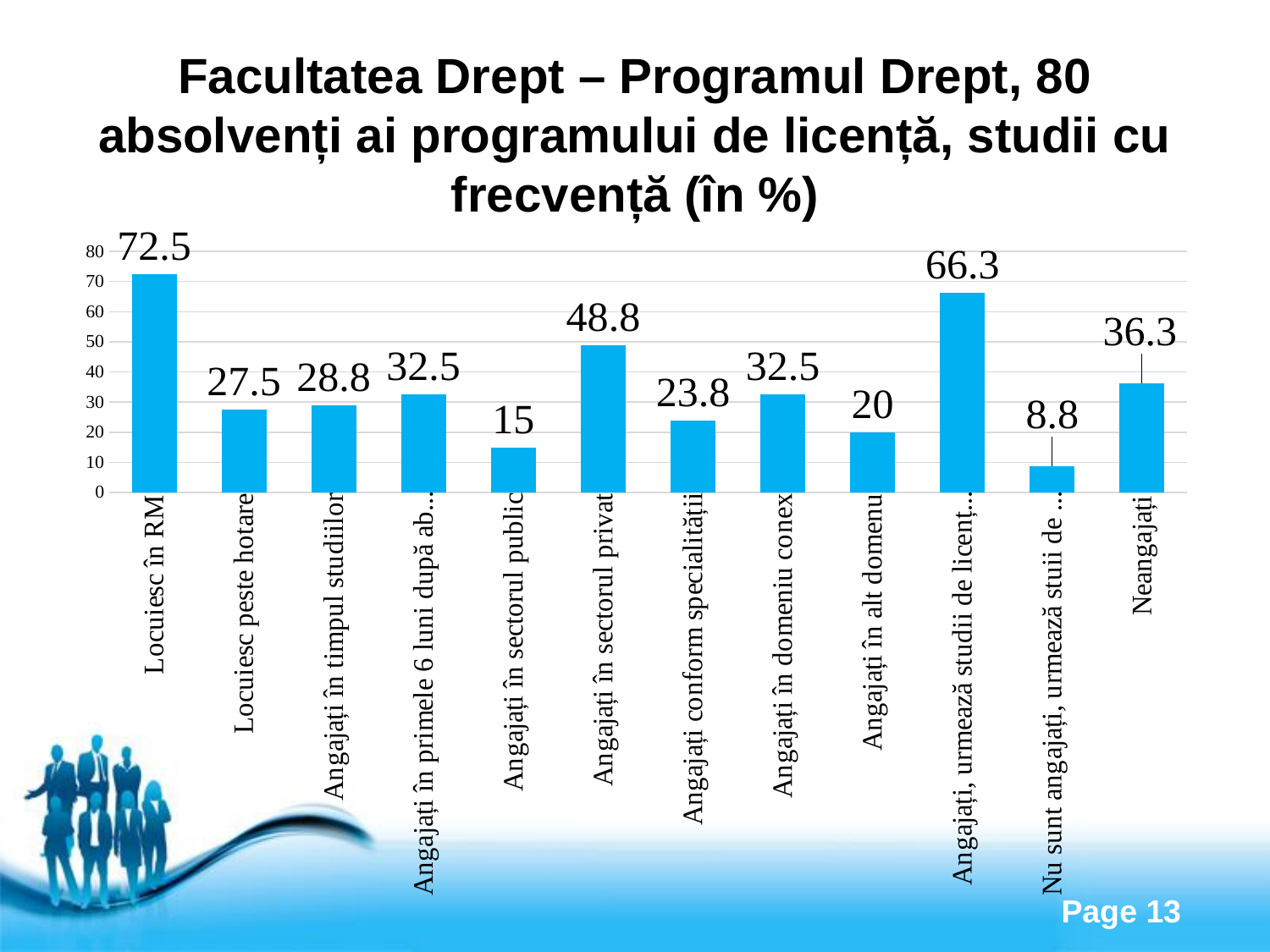
What is the difference between the values for "Angajați în domeniu conex" and "Angajați în alt domenu"? 12.5 What is the value for "Angajați în sectorul privat"? 48.8 What is the value for "Angajați în sectorul public"? 15 Which category has the highest value? Locuiesc în RM How many categories are shown in the chart? 12 Which category has the lowest value? Nu sunt angajați, urmează stuii de ... What is the value for "Locuiesc în RM"? 72.5 What is the difference between the values for "Locuiesc în RM" and "Locuiesc peste hotare"? 45 What is the value for "Neangajați"? 36.3 Which is larger: the value for "Angajați în sectorul privat" or the value for "Neangajați"? Angajați în sectorul privat What kind of chart is shown on the slide? Bar chart Is the value for "Angajați conform specialității" greater or less than 30? less